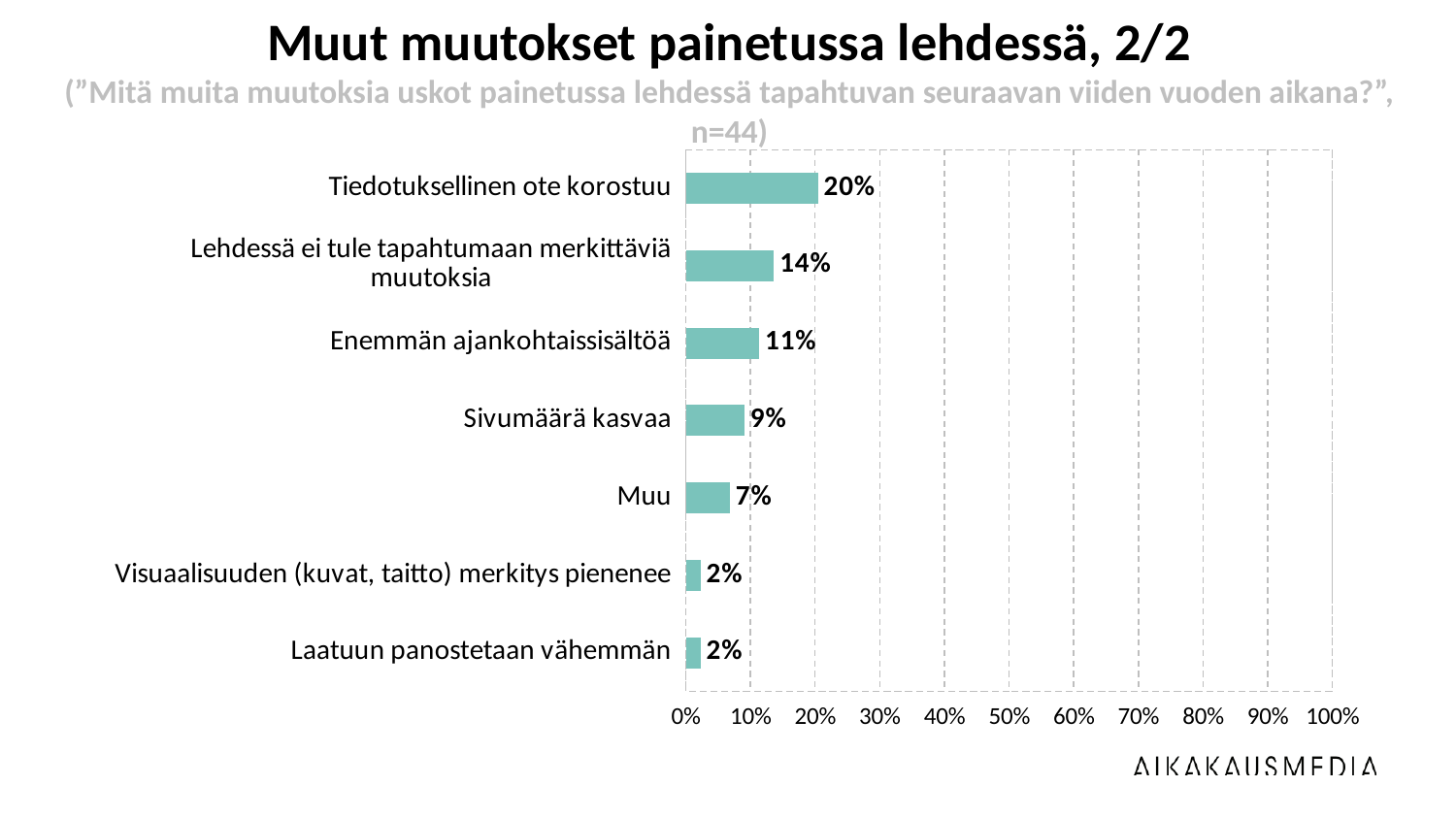
What is the difference between "Tiedotuksellinen ote korostuu" and "Lehdessä ei tule tapahtumaan merkittäviä muutoksia"? 6% Which category has the highest value? Tiedotuksellinen ote korostuu Which is larger, "Enemmän ajankohtaissisältöä" or "Sivumäärä kasvaa"? Enemmän ajankohtaissisältöä What is the sample size (n) stated in the subtitle? n=44 What is the value for "Muu"? 7% What is the title of the chart? Muut muutokset painetussa lehdessä, 2/2 What is the value for "Tiedotuksellinen ote korostuu"? 20% What is the value for "Sivumäärä kasvaa"? 9% How many categories are shown in the chart? 7 What is the value for "Enemmän ajankohtaissisältöä"? 11% What kind of chart is shown on the slide? bar chart Is the value for "Lehdessä ei tule tapahtumaan merkittäviä muutoksia" greater or less than 10%? greater